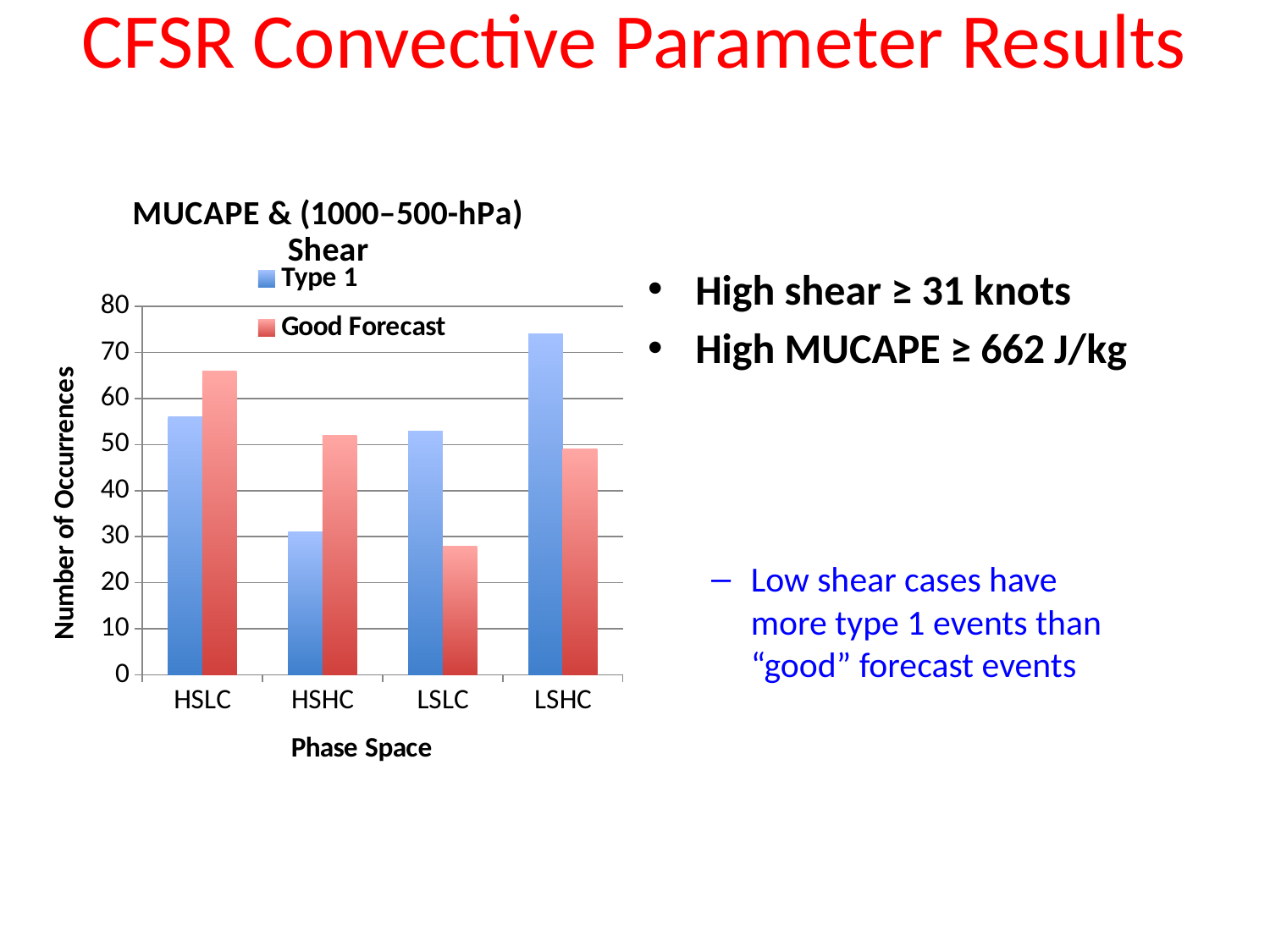
Which phase space category has the highest Good Forecast value? HSLC Is the Good Forecast value for LSLC greater or less than 30? less How many phase space categories are shown on the x axis? 4 Which phase space category has the lowest Good Forecast value? LSLC For HSHC, which is larger: Type 1 or Good Forecast? Good Forecast What kind of chart is shown on the slide? bar chart Which phase space category has the highest Type 1 value? LSHC How many series does the chart legend list? 2 Is the Type 1 value for LSHC greater or less than 70? greater What is the label of the y axis of the chart? Number of Occurrences For LSLC, which is larger: Type 1 or Good Forecast? Type 1 Which phase space category has the lowest Type 1 value? HSHC